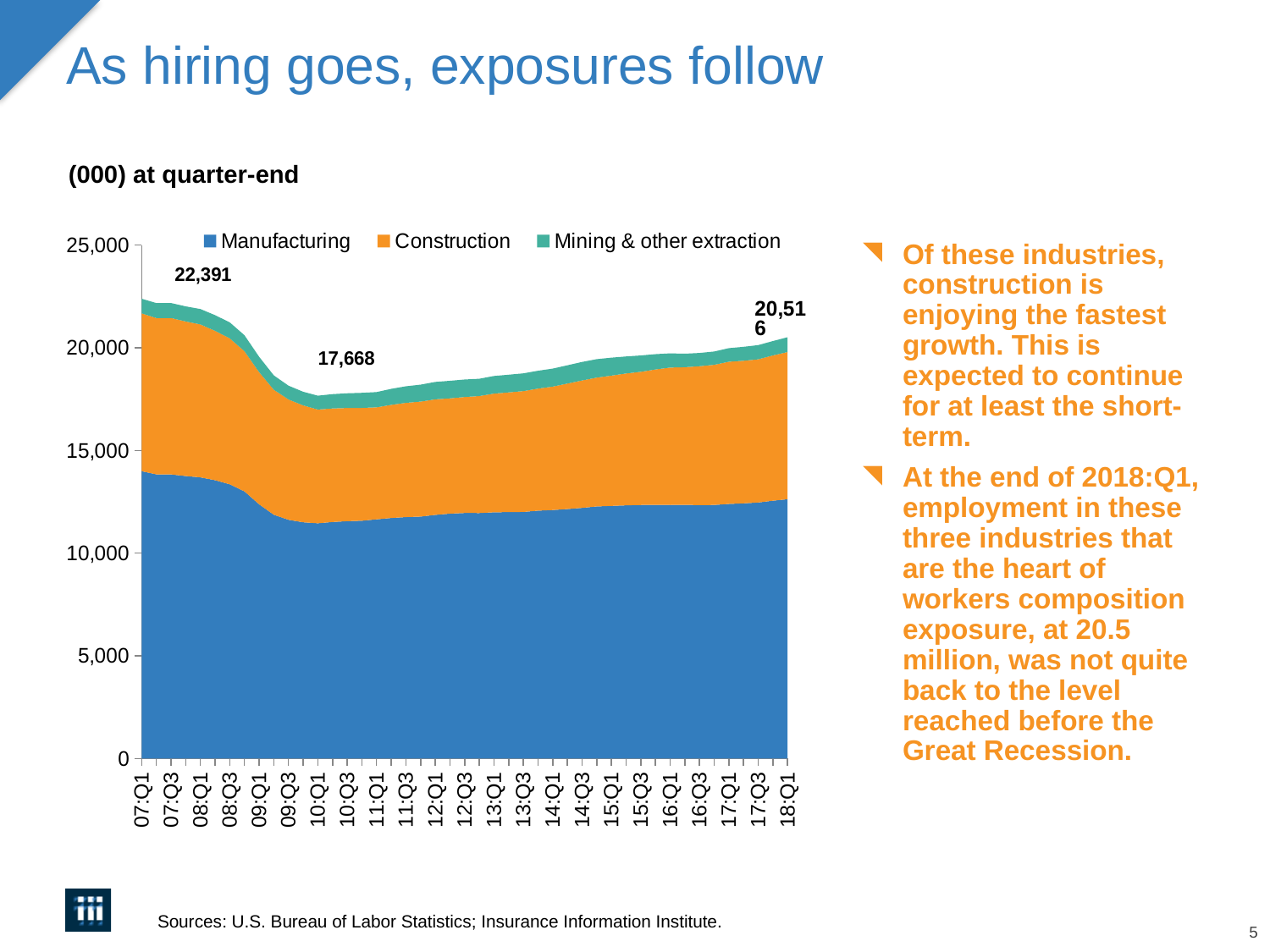
Which is larger, the labeled total at 18:Q1 or the labeled total at 10:Q1? 18:Q1 Which three series are listed in the chart legend? Manufacturing, Construction, Mining & other extraction What is the difference between the labeled total at 18:Q1 and the labeled total at 10:Q1? 2,848 What is the labeled total employment value at the 10:Q1 trough? 17,668 What is the labeled total employment value at 18:Q1? 20,516 How many series does the chart legend list? 3 What kind of chart is shown on the slide? Stacked area chart What is the lowest total value labeled on the chart? 17,668 Is the Manufacturing value at 18:Q1 greater or less than 15,000? less What is the difference between the labeled values 22,391 and 20,516? 1,875 Does the total employment rise or fall from 10:Q1 to 18:Q1? rise What is the highest total value labeled on the chart? 22,391